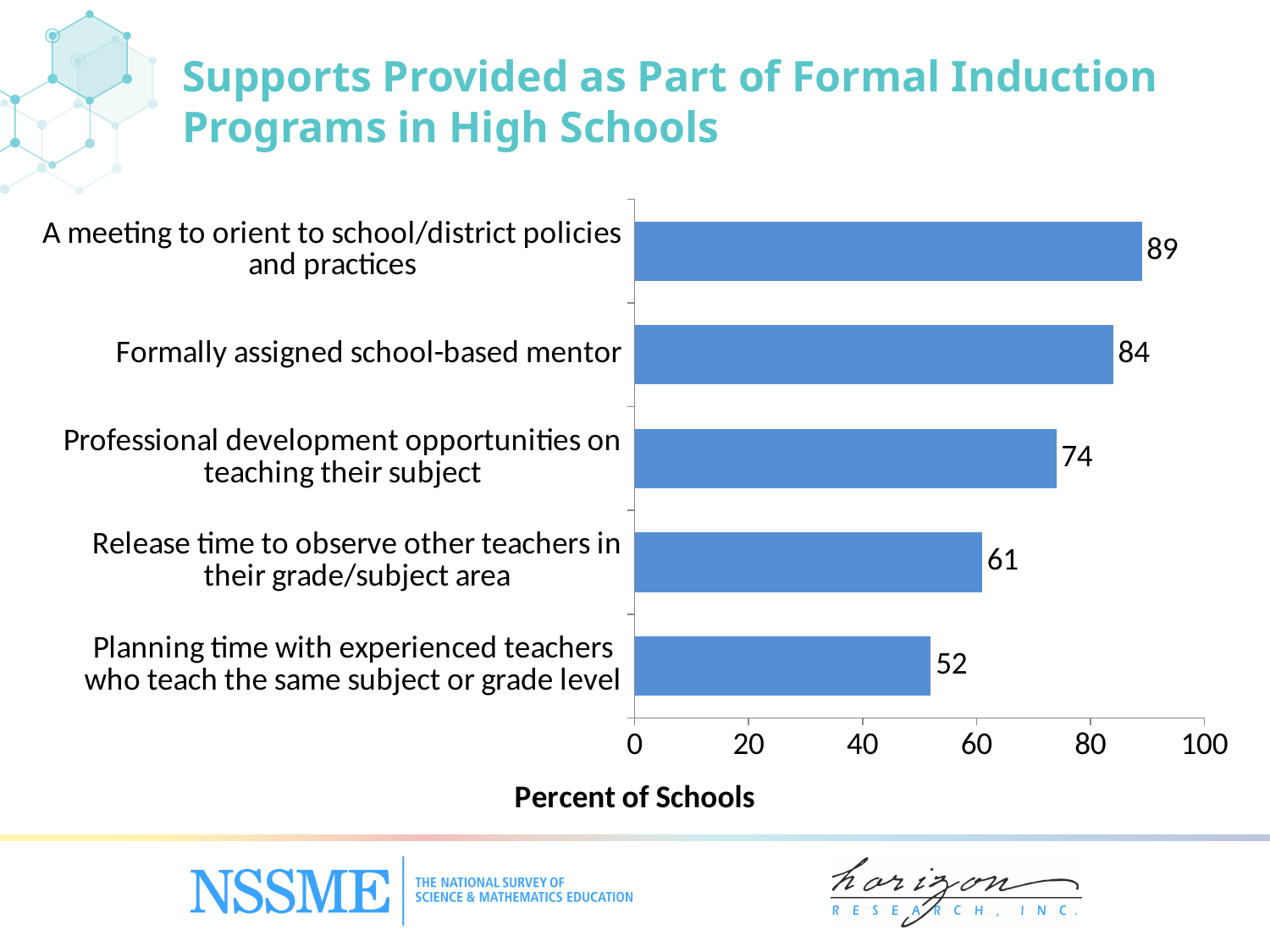
Which is larger: the value for 'Formally assigned school-based mentor' or the value for 'Release time to observe other teachers in their grade/subject area'? Formally assigned school-based mentor What percent of high schools provide a formally assigned school-based mentor as part of formal induction programs? 84 What percent of schools provide release time to observe other teachers in their grade/subject area? 61 Which support has the highest percent of schools? A meeting to orient to school/district policies and practices Which support has the lowest percent of schools? Planning time with experienced teachers who teach the same subject or grade level What is the label of the horizontal axis? Percent of Schools What is the value for 'Planning time with experienced teachers who teach the same subject or grade level'? 52 How many supports (categories) are shown in the chart? 5 Is the value for 'Professional development opportunities on teaching their subject' greater or less than 80? less What is the title of the chart on the slide? Supports Provided as Part of Formal Induction Programs in High Schools What is the difference between the value for 'A meeting to orient to school/district policies and practices' and the value for 'Professional development opportunities on teaching their subject'? 15 What kind of chart is shown on the slide? Bar chart